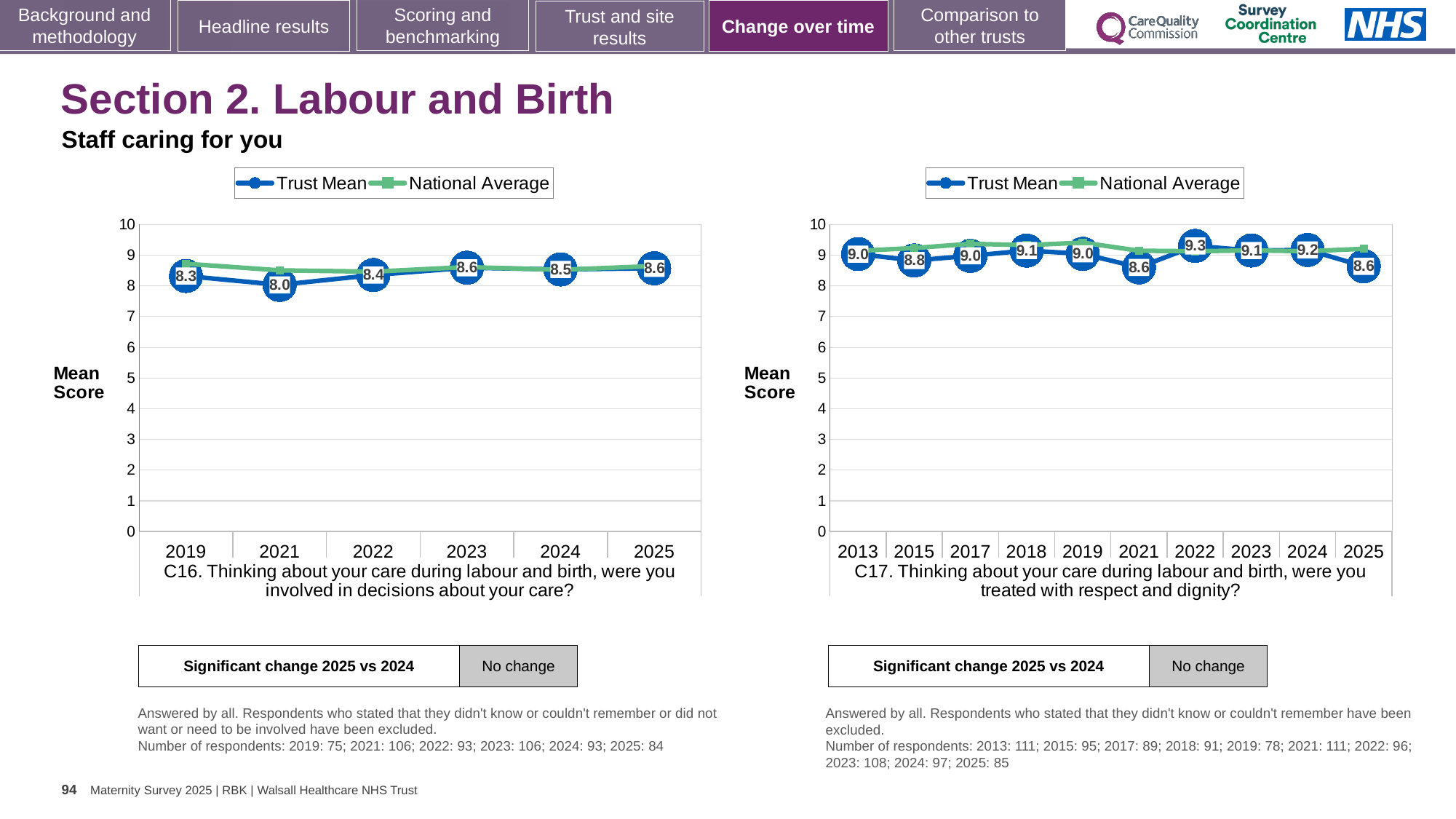
In the C16 chart on the left, what is the Trust Mean for 2021? 8.0 In the C17 chart on the right, which year has the highest Trust Mean? 2022 In the C16 chart on the left, which year has the lowest Trust Mean? 2021 In the C17 chart on the right, which is larger, the Trust Mean for 2024 or for 2025? 2024 In the C16 chart on the left, what is the Trust Mean for 2025? 8.6 In the C17 chart on the right, how many years are shown on the x axis? 10 In the C16 chart on the left, what is the difference between the Trust Mean for 2023 and 2021? 0.6 What kind of chart is the C16 chart on the left? Line chart How many series does the legend of the C17 chart on the right list? 2 In the C17 chart on the right, what is the Trust Mean for 2022? 9.3 In the C16 chart on the left, how many years are shown on the x axis? 6 In the C16 chart on the left, is the National Average for 2019 greater or less than 8? greater